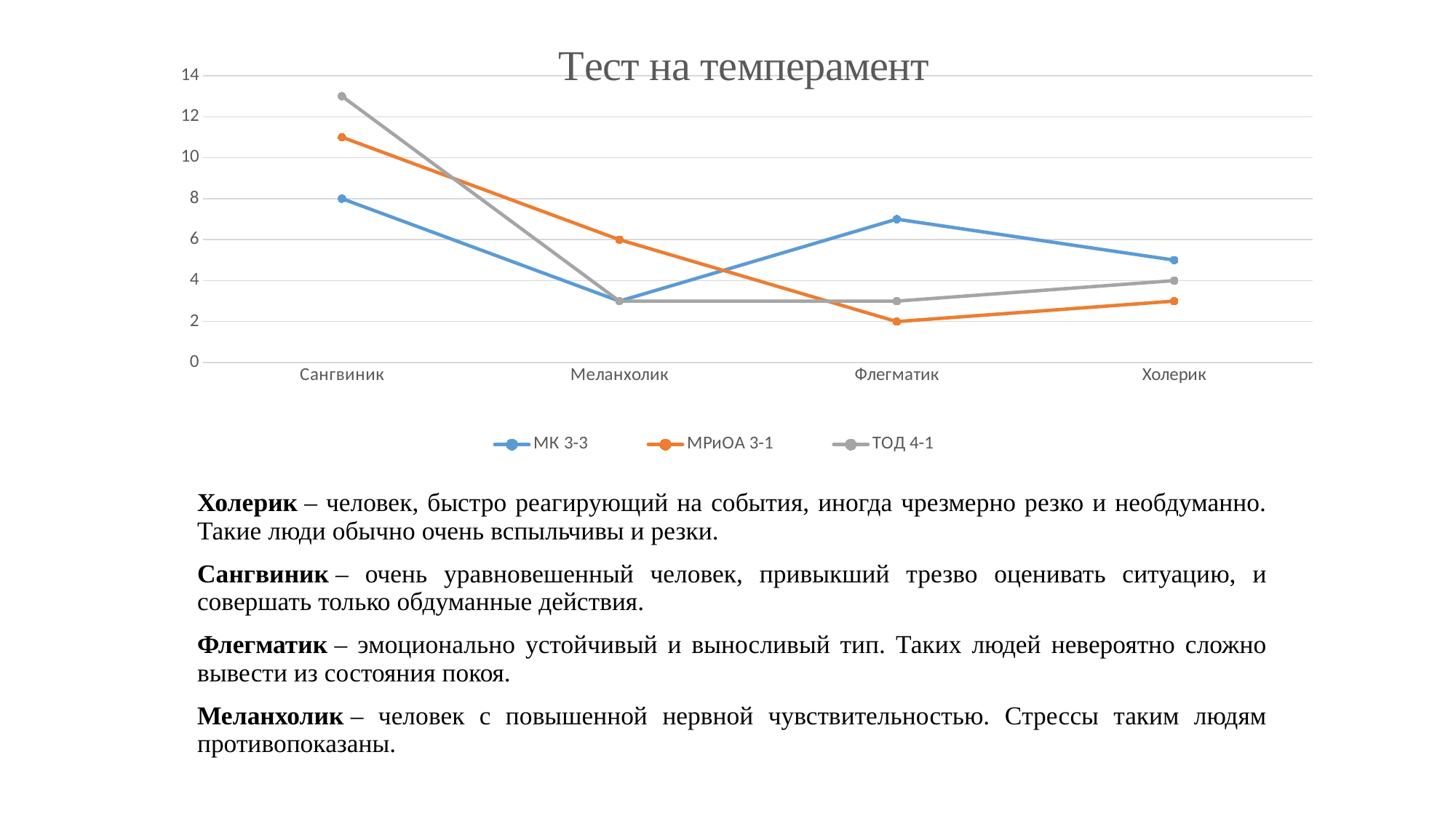
What is the value for МК 3-3 at Сангвиник? 8 Is the value for ТОД 4-1 at Сангвиник greater or less than 12? greater What is the title of the chart? Тест на темперамент How many categories are shown on the x axis? 4 Does the МРиОА 3-1 line rise or fall from Сангвиник to Флегматик? fall Which series has the lowest value at Флегматик? МРиОА 3-1 Which series has the highest value at Сангвиник? ТОД 4-1 What is the value for ТОД 4-1 at Холерик? 4 What is the value for МРиОА 3-1 at Меланхолик? 6 How many series does the legend list? 3 What is the value for МРиОА 3-1 at Флегматик? 2 What kind of chart is shown on the slide? line chart